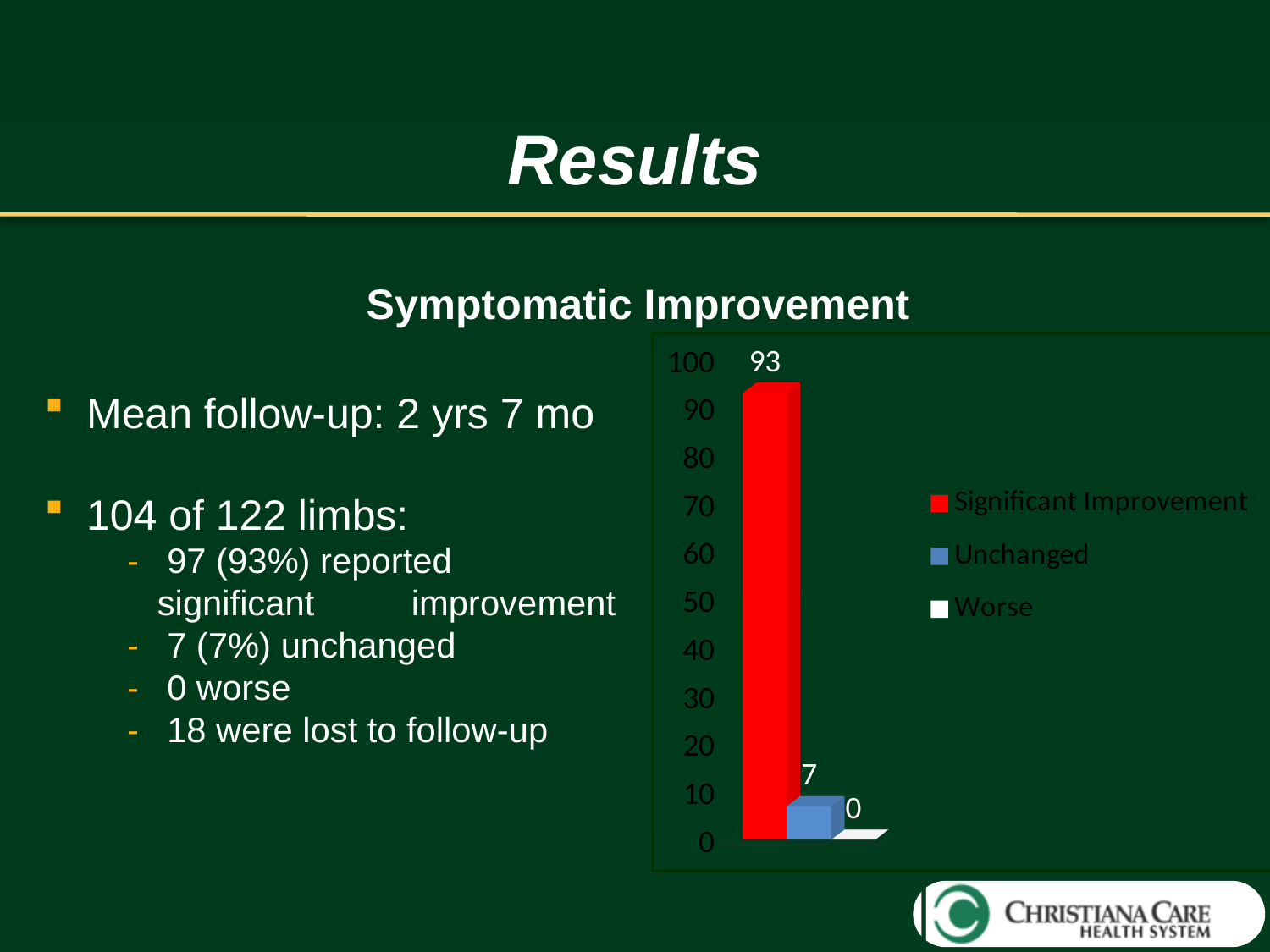
Which is larger, the value for Unchanged or the value for Worse? Unchanged What kind of chart is shown on the slide? bar chart Which series has the lowest value in the chart? Worse Which series has the highest value in the chart? Significant Improvement What is the difference between the Significant Improvement value and the Unchanged value? 86 What value is shown for Unchanged in the chart? 7 What value is shown for Significant Improvement in the chart? 93 Is the value for Significant Improvement greater or less than 90? greater What is the title shown above the chart? Symptomatic Improvement What colour is the Significant Improvement bar in the chart? red What value is shown for Worse in the chart? 0 How many series does the chart legend list? 3